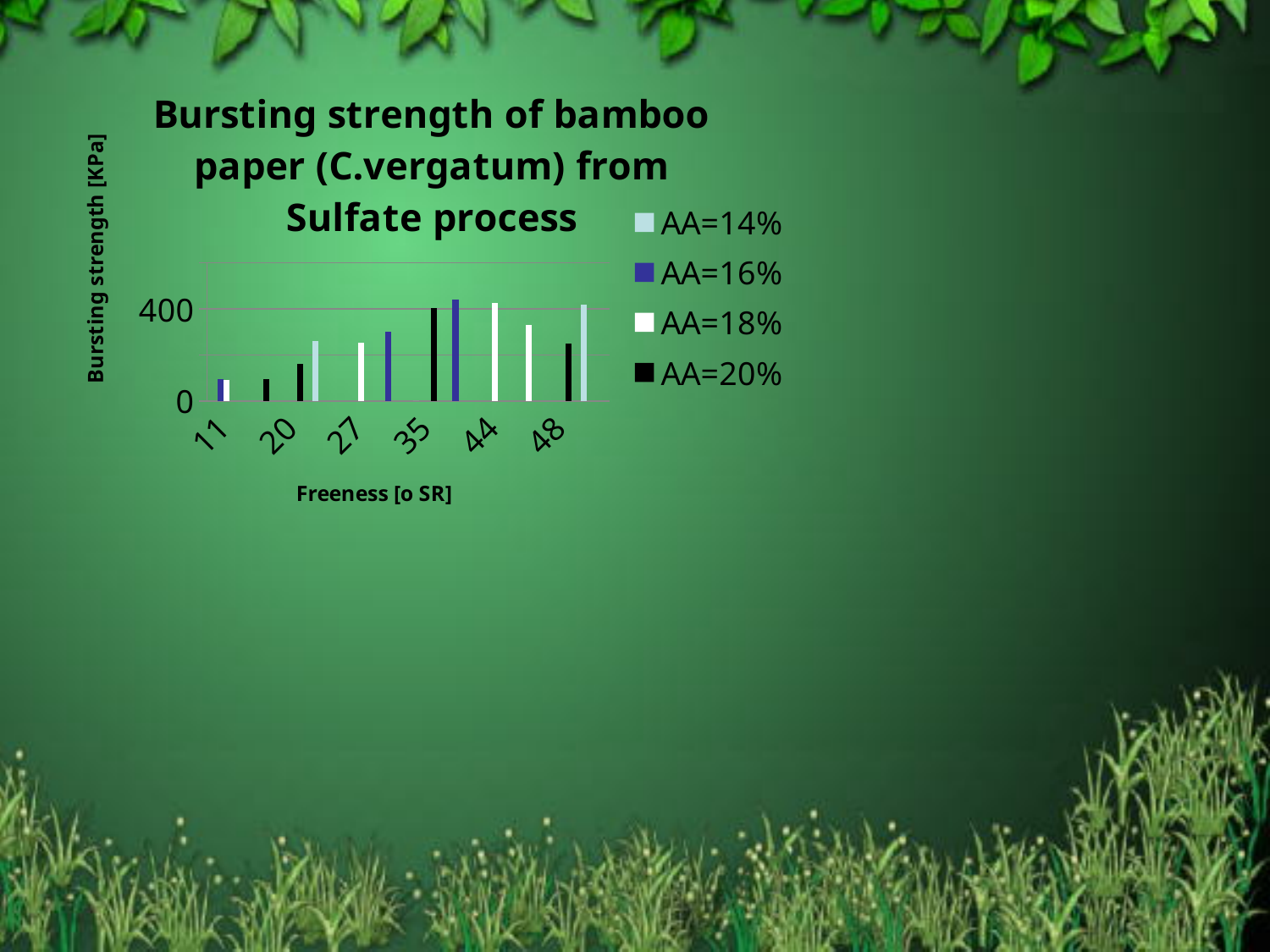
What kind of chart is shown on the slide? bar chart Which freeness category has the lowest bursting strength values? 11 How many freeness categories are shown on the x axis? 6 How many series does the legend list? 4 What is the label of the y axis? Bursting strength [KPa] Is the value for AA=16% at freeness 11 greater or less than 400? less Do the bursting strength values generally rise or fall from freeness 11 to freeness 35? rise What is the title of the chart? Bursting strength of bamboo paper (C.vergatum) from Sulfate process